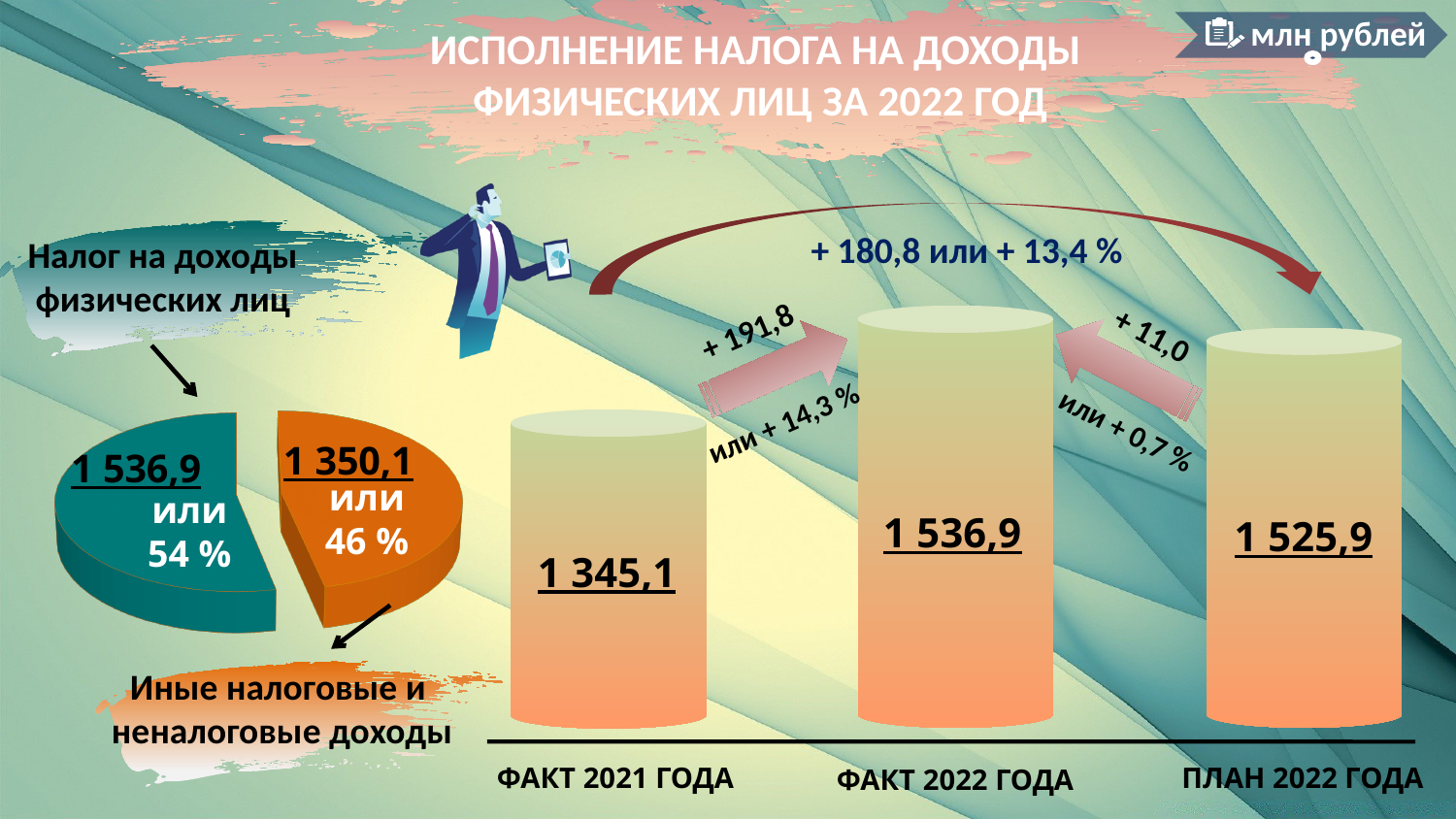
On the bar chart, which category has the lowest value? ФАКТ 2021 ГОДА On the pie chart, what share does Налог на доходы физических лиц have? 54 % On the bar chart, which category has the highest value? ФАКТ 2022 ГОДА On the bar chart, what is the value for ФАКТ 2021 ГОДА? 1 345,1 On the bar chart, what is the value for ПЛАН 2022 ГОДА? 1 525,9 On the bar chart, what is the value for ФАКТ 2022 ГОДА? 1 536,9 On the pie chart, what is the value for Иные налоговые и неналоговые доходы? 1 350,1 On the bar chart, what is the difference between ФАКТ 2022 ГОДА and ПЛАН 2022 ГОДА? 11,0 What unit of measurement is indicated in the top right corner of the slide? млн рублей On the bar chart, what is the difference between ФАКТ 2022 ГОДА and ФАКТ 2021 ГОДА? 191,8 How many bars are shown on the bar chart? 3 On the bar chart, which is larger: ФАКТ 2022 ГОДА or ПЛАН 2022 ГОДА? ФАКТ 2022 ГОДА